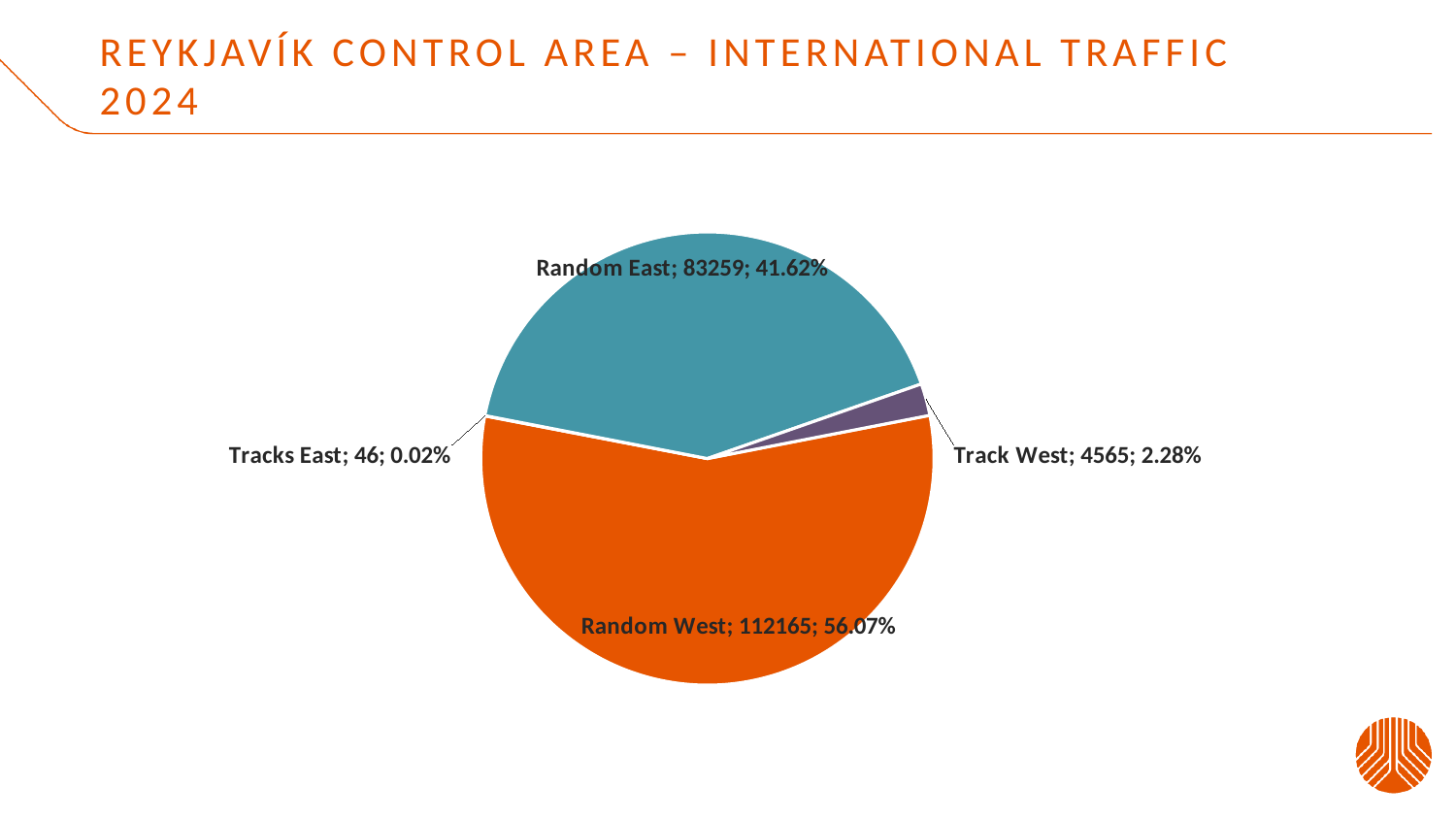
Which is larger, Track West or Tracks East? Track West What share of the pie does Random West represent? 56.07% What share of the pie does Track West represent? 2.28% What is the value for Random West? 112165 How many slices does the pie chart have? 4 Which category has the largest slice? Random West Which category has the smallest slice? Tracks East What kind of chart is shown on the slide? pie chart What is the value for Tracks East? 46 What is the value for Track West? 4565 What is the difference between the values for Random West and Random East? 28906 What is the value for Random East? 83259